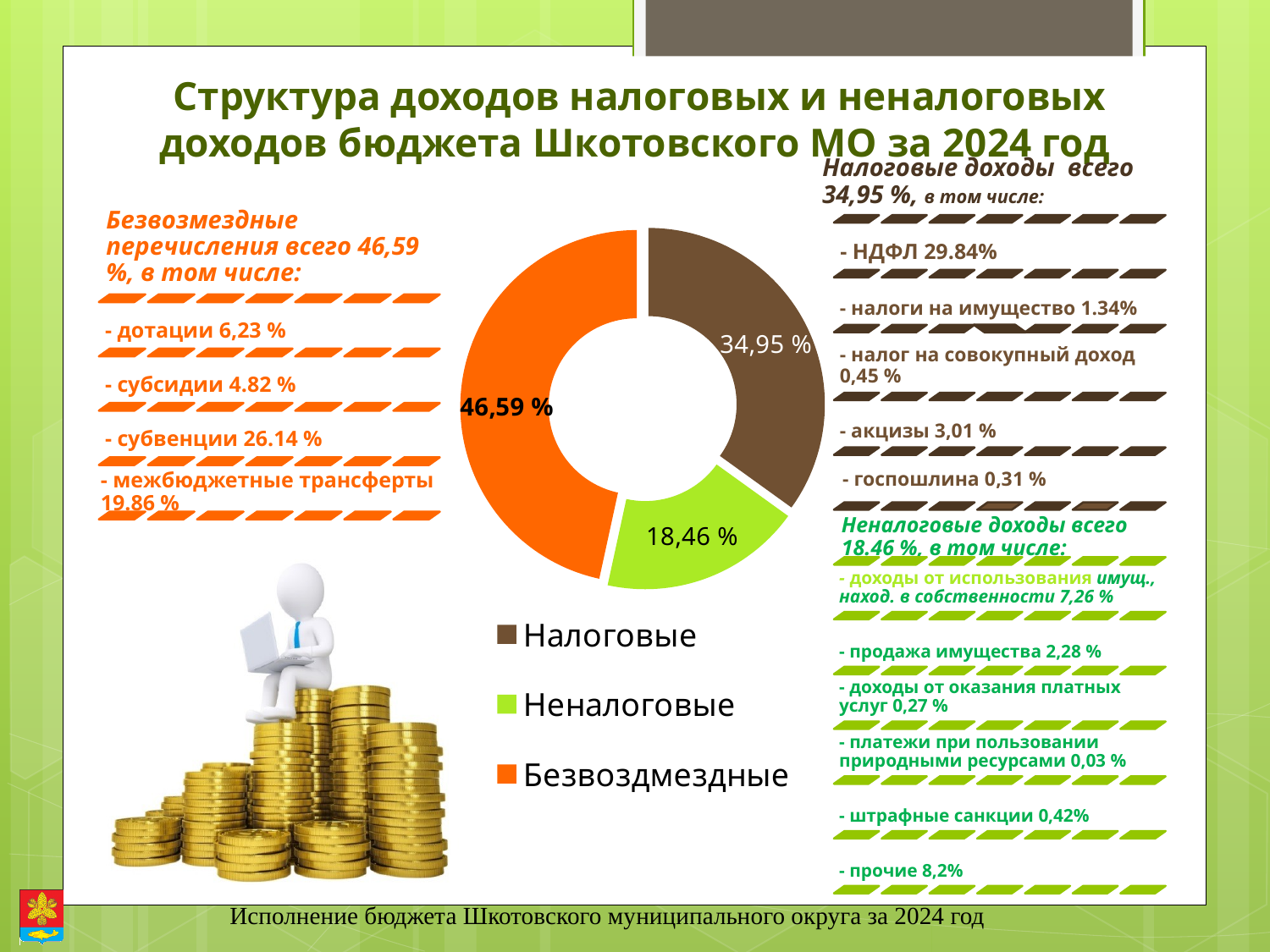
Which category has the smallest share of the pie? Неналоговые What is the value shown for the Налоговые slice? 34,95 % Which category has the largest share of the pie? Безвоздмездные What is the value shown for the Неналоговые slice? 18,46 % What kind of chart is shown on the slide? Pie chart (donut) What is the difference between the Безвоздмездные and Налоговые values? 11,64 % What is the difference between the Налоговые and Неналоговые values? 16,49 % What colour is the Безвоздмездные slice in the chart? Orange How many slices does the pie chart have? 3 What is the value shown for the Безвоздмездные slice? 46,59 % Which is larger, Налоговые or Неналоговые? Налоговые How many entries does the legend list? 3